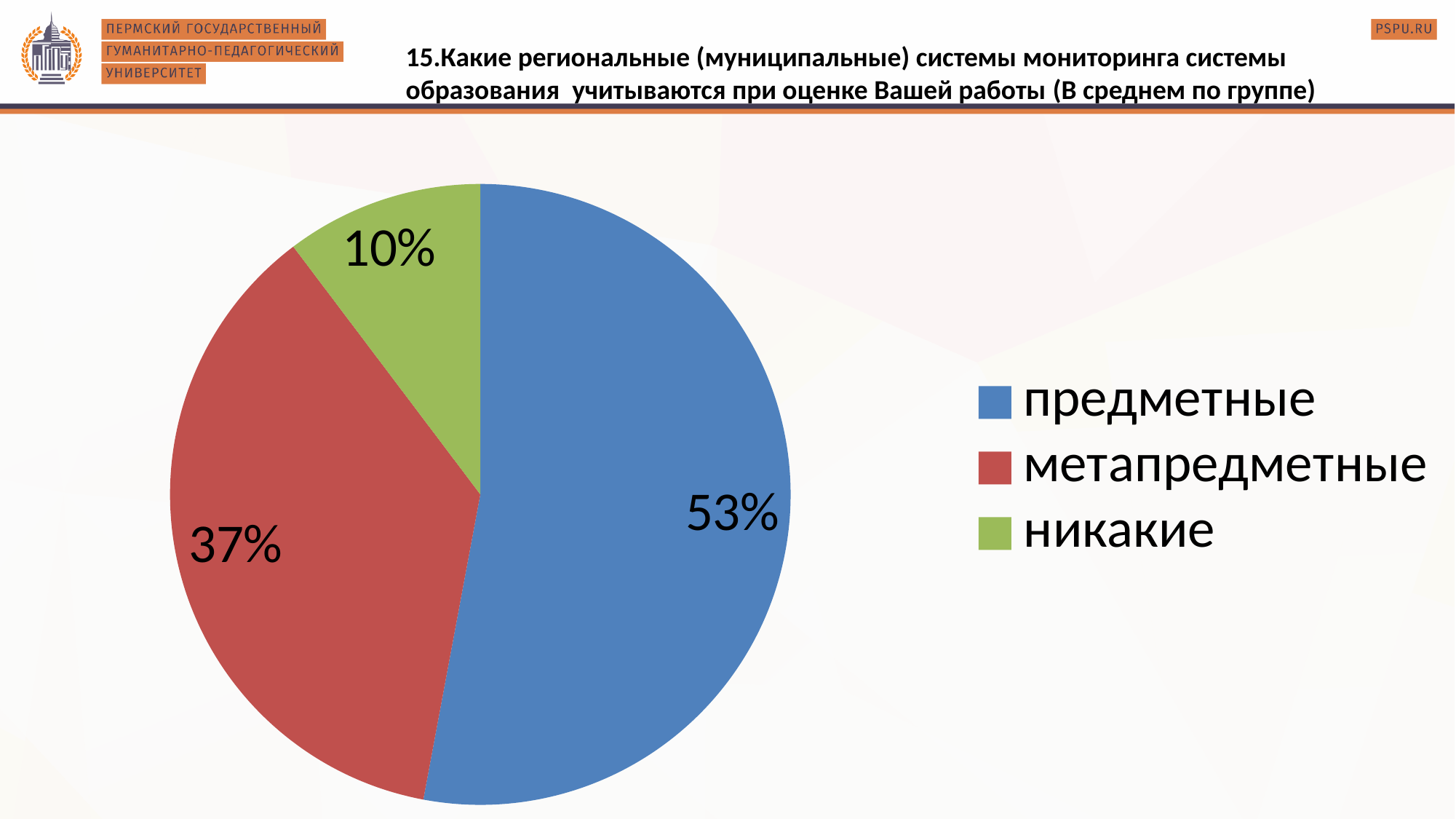
What is the difference in percentage points between "метапредметные" and "никакие"? 27 What kind of chart is shown on the slide? pie chart What share of the pie does "никакие" have? 10% Which category has the largest slice of the pie? предметные Which category has the smallest slice of the pie? никакие Which category is shown in blue in the legend? предметные What share of the pie does "метапредметные" have? 37% What share of the pie does "предметные" have? 53% Which is larger, the slice for "метапредметные" or the slice for "никакие"? метапредметные What is the difference in percentage points between "предметные" and "метапредметные"? 16 How many categories does the pie chart have? 3 What colour is the slice for "никакие"? green